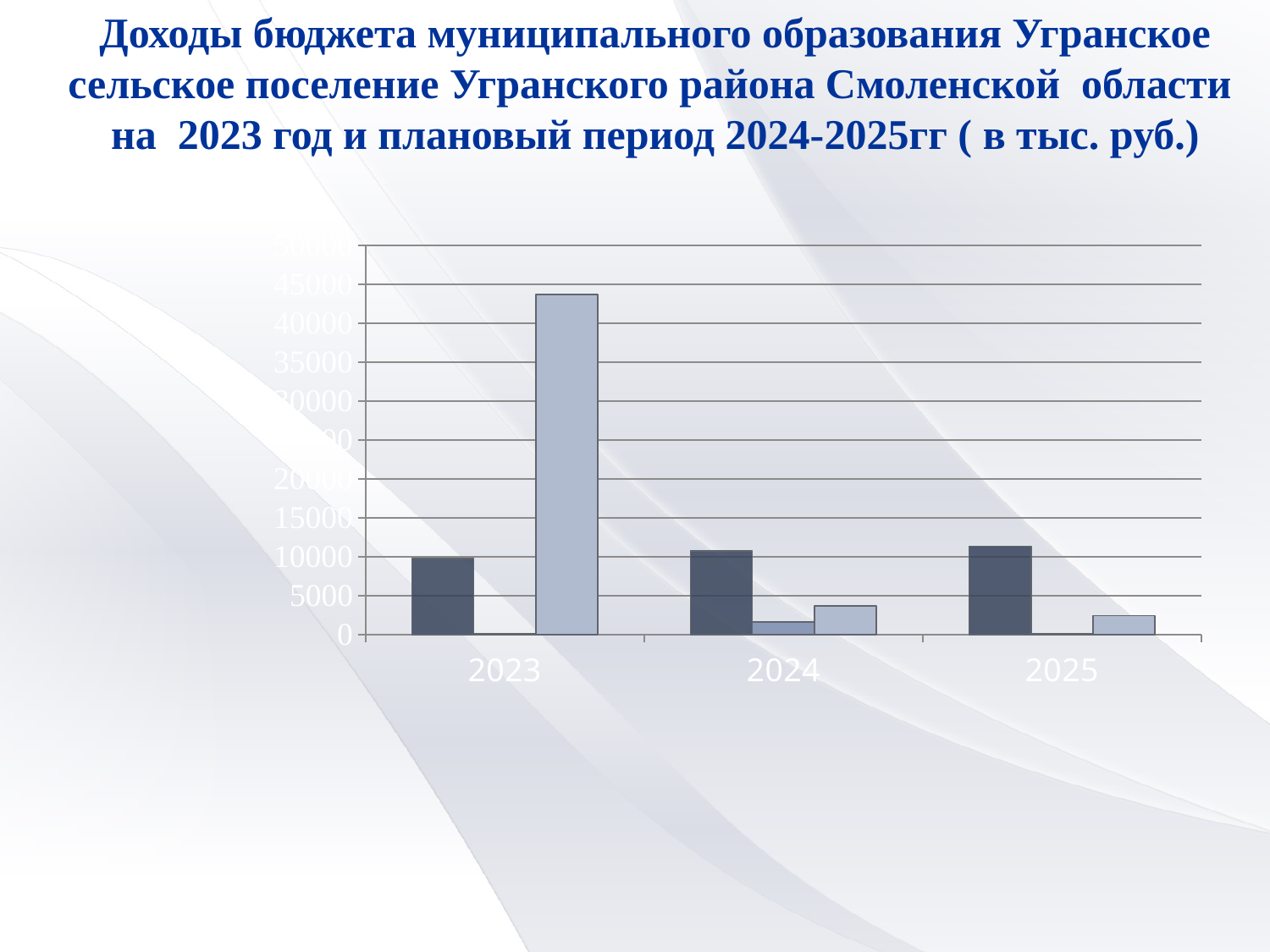
Which is larger for 2024: the dark blue bar or the light blue bar? the dark blue bar What kind of chart is shown on the slide? bar chart Is the value of the light blue bar for 2023 greater or less than 40000? greater Is the value of the light blue bar for 2023 greater or less than 45000? less Which is larger for 2023: the dark blue bar or the light blue bar? the light blue bar In what units are the values on the slide given, according to the title? тыс. руб. Is the value of the light blue bar for 2024 greater or less than 5000? less Do the dark blue bars rise or fall from 2023 to 2025? rise How many year categories are shown on the x axis of the chart? 3 Which year has the tallest bar in the chart? 2023